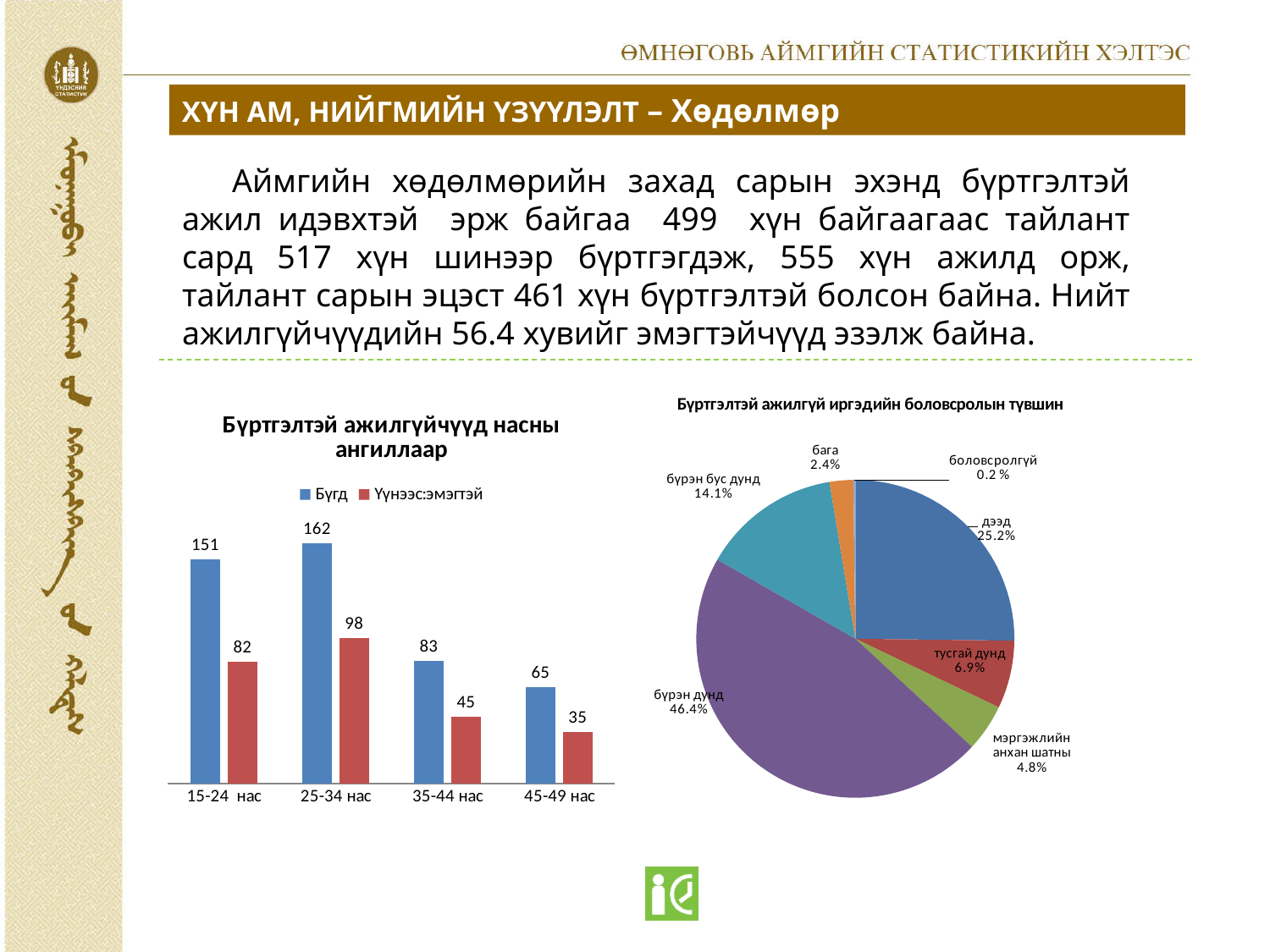
In the pie chart 'Бүртгэлтэй ажилгүй иргэдийн боловсролын түвшин', how many slices are there? 7 In the chart 'Бүртгэлтэй ажилгүйчүүд насны ангиллаар', how many age groups are shown on the x axis? 4 In the pie chart 'Бүртгэлтэй ажилгүй иргэдийн боловсролын түвшин', which is larger: дээд or бүрэн бус дунд? дээд In the chart 'Бүртгэлтэй ажилгүйчүүд насны ангиллаар', which age group has the lowest Үүнээс:эмэгтэй value? 45-49 нас In the pie chart 'Бүртгэлтэй ажилгүй иргэдийн боловсролын түвшин', what share does бүрэн дунд have? 46.4% What kind of chart is 'Бүртгэлтэй ажилгүйчүүд насны ангиллаар'? bar chart In the pie chart 'Бүртгэлтэй ажилгүй иргэдийн боловсролын түвшин', which category has the smallest share? боловсролгүй In the chart 'Бүртгэлтэй ажилгүйчүүд насны ангиллаар', what is the value of Бүгд for 25-34 нас? 162 In the chart 'Бүртгэлтэй ажилгүйчүүд насны ангиллаар', what is the difference between Бүгд and Үүнээс:эмэгтэй for 15-24 нас? 69 In the chart 'Бүртгэлтэй ажилгүйчүүд насны ангиллаар', which age group has the highest Бүгд value? 25-34 нас In the chart 'Бүртгэлтэй ажилгүйчүүд насны ангиллаар', what is the value of Үүнээс:эмэгтэй for 35-44 нас? 45 In the chart 'Бүртгэлтэй ажилгүйчүүд насны ангиллаар', how many series does the legend list? 2